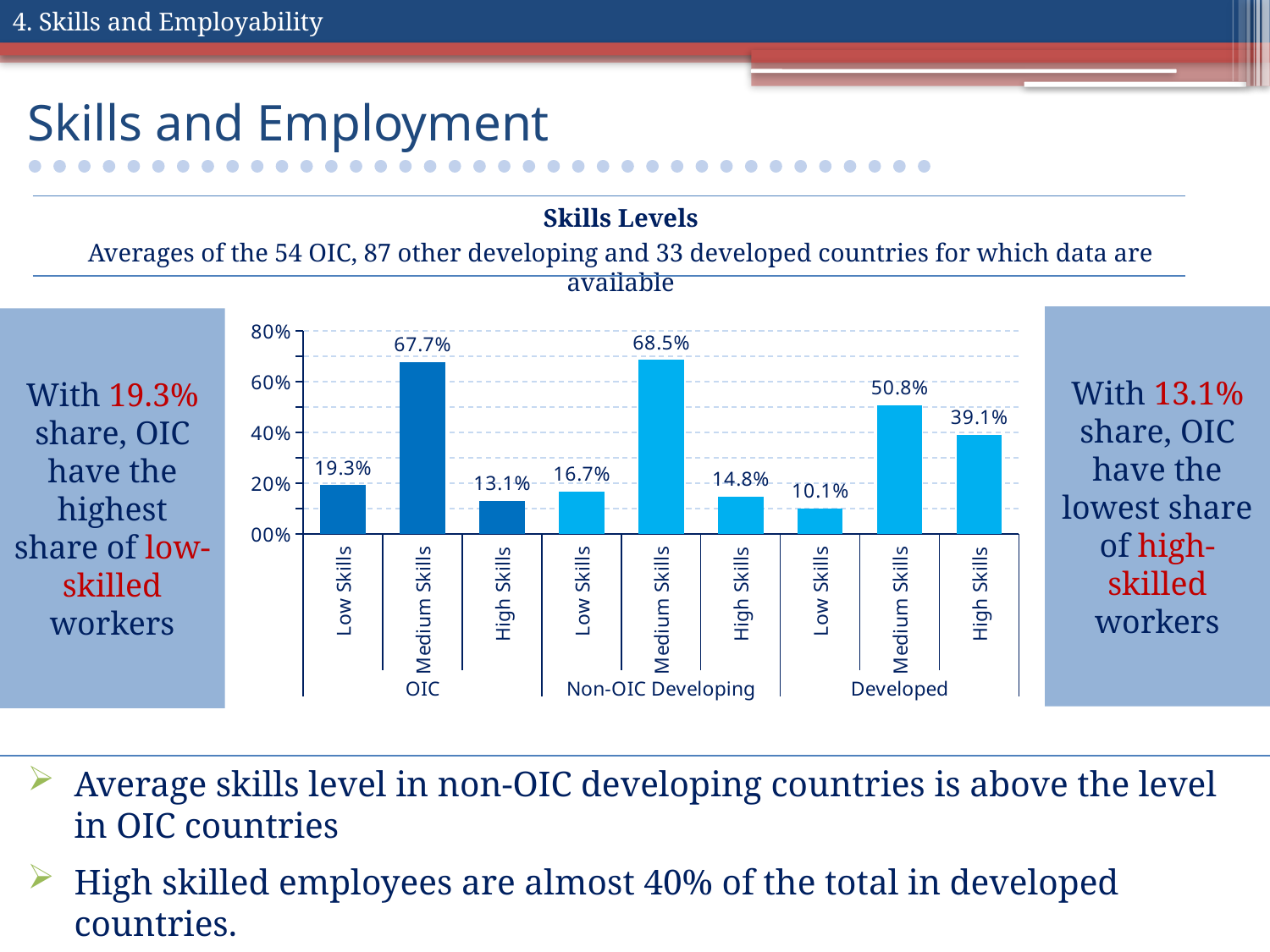
Which is larger: Low Skills in OIC or Low Skills in Non-OIC Developing? Low Skills in OIC Is the value for Medium Skills in the Developed group greater or less than 40%? greater What is the value for High Skills in the Developed group? 39.1% What is the value for Low Skills in the OIC group? 19.3% How many bars are plotted in the chart? 9 What is the title of the chart? Skills Levels What type of chart is shown on the slide? Bar chart What is the difference between the High Skills values for Developed and OIC? 26.0% Which bar has the lowest value in the chart? Low Skills, Developed What is the value for Medium Skills in the Non-OIC Developing group? 68.5% What is the value for Low Skills in the Developed group? 10.1% Which bar has the highest value in the chart? Medium Skills, Non-OIC Developing